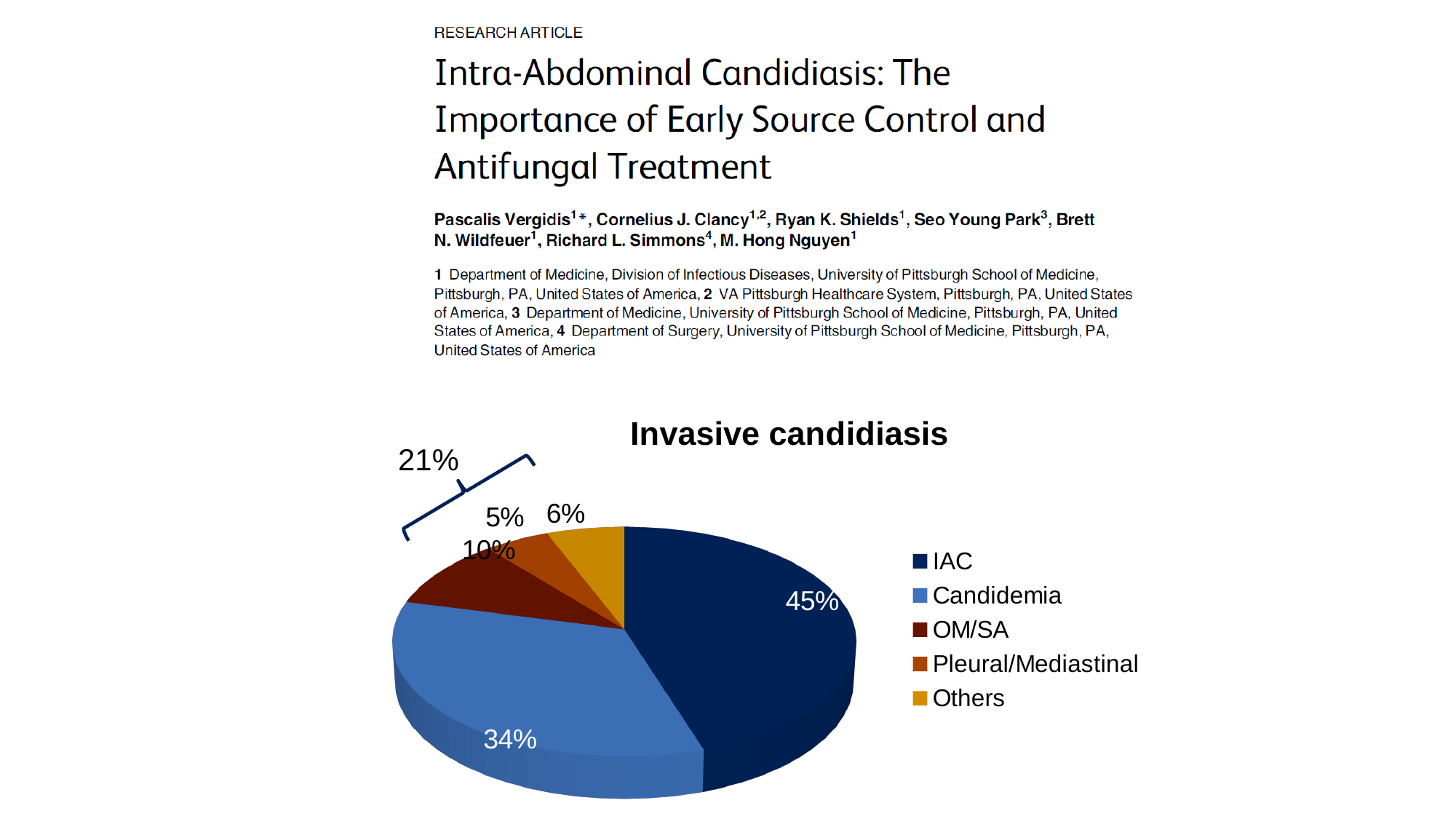
Which category has the largest share of the pie? IAC What percentage of the pie is IAC? 45% What is the difference in percentage points between IAC and Candidemia? 11 What percentage of the pie is Pleural/Mediastinal? 5% How many categories does the legend list? 5 Which is larger, the share for Others or the share for Pleural/Mediastinal? Others Which category has the smallest share of the pie? Pleural/Mediastinal What is the title of the chart? Invasive candidiasis What percentage of the pie is OM/SA? 10% What kind of chart is shown on the slide? Pie chart What percentage of the pie is Others? 6% What percentage of the pie is Candidemia? 34%